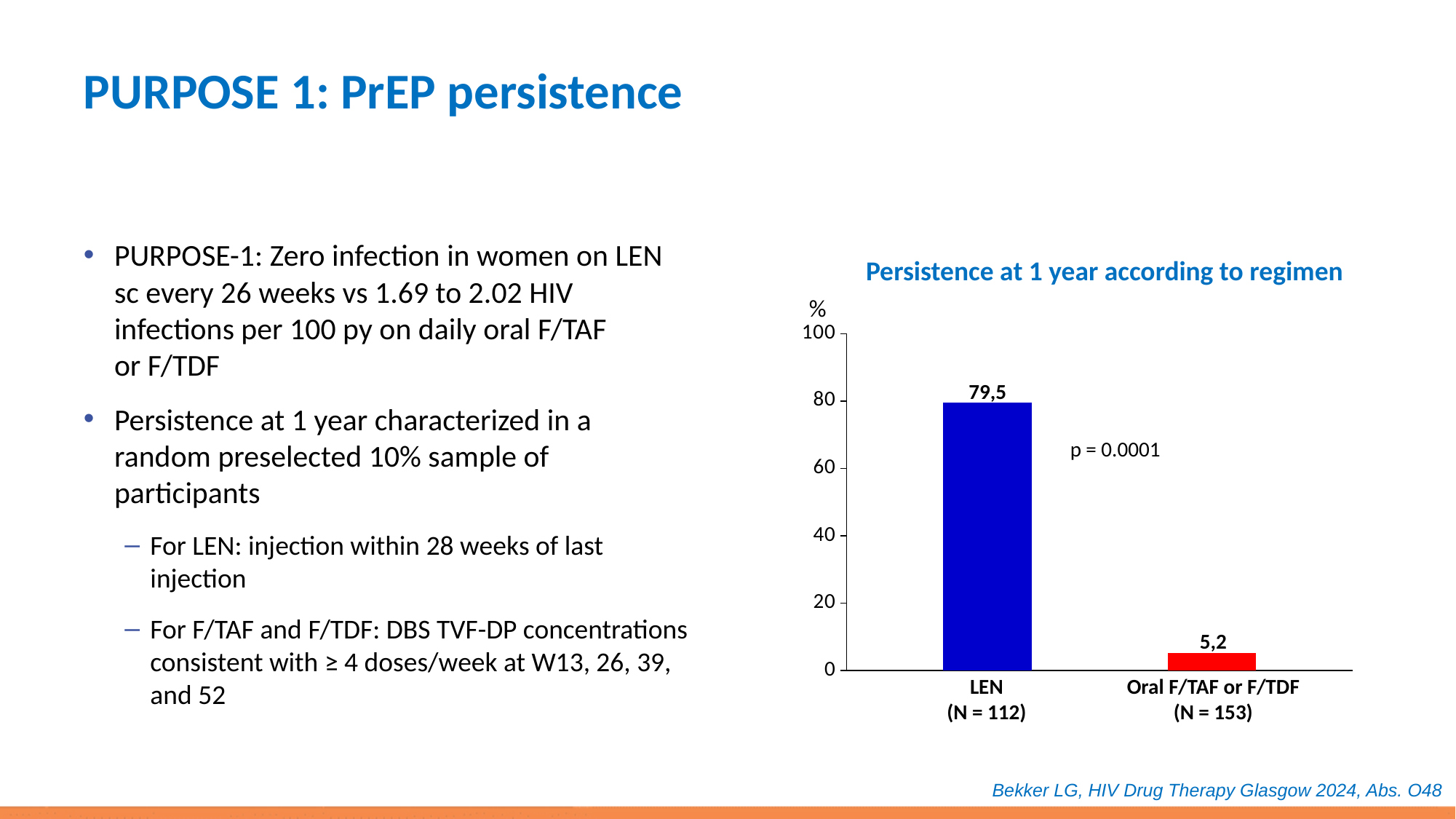
What is the persistence at 1 year for LEN (N = 112)? 79,5 What is the difference in persistence at 1 year between LEN and Oral F/TAF or F/TDF? 74,3 What kind of chart is shown on the slide? Bar chart What is the title of the chart? Persistence at 1 year according to regimen Is the persistence value for Oral F/TAF or F/TDF greater or less than 20? less How many regimens are shown in the chart? 2 Which regimen has the lowest persistence at 1 year? Oral F/TAF or F/TDF Is the persistence value for LEN greater or less than 60? greater What p-value is shown on the chart? p = 0.0001 What is the persistence at 1 year for Oral F/TAF or F/TDF (N = 153)? 5,2 Which regimen has the highest persistence at 1 year? LEN Which has a larger persistence at 1 year, LEN or Oral F/TAF or F/TDF? LEN